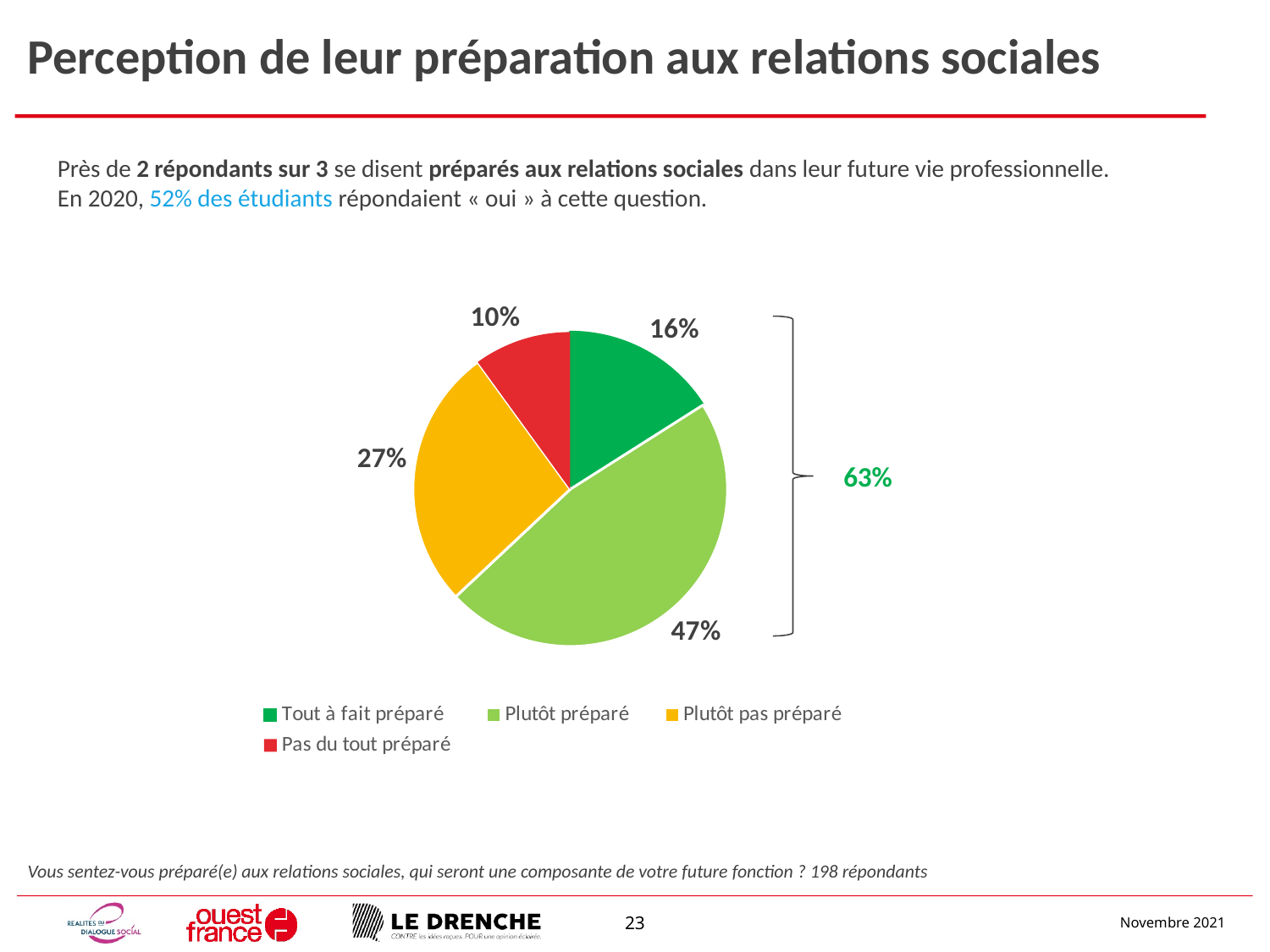
Which category has the largest share of the pie? Plutôt préparé Which is larger: the share for "Tout à fait préparé" or the share for "Plutôt pas préparé"? Plutôt pas préparé What percentage of respondents answered "Pas du tout préparé"? 10% Which category has the smallest share of the pie? Pas du tout préparé What is the difference in percentage points between "Plutôt préparé" and "Plutôt pas préparé"? 20 What percentage of respondents answered "Plutôt préparé"? 47% What percentage of respondents answered "Tout à fait préparé"? 16% What combined percentage is indicated by the bracket next to the pie chart? 63% What percentage of respondents answered "Plutôt pas préparé"? 27% What kind of chart is shown on the slide? pie chart What colour is the "Pas du tout préparé" slice? red How many categories does the pie chart have? 4